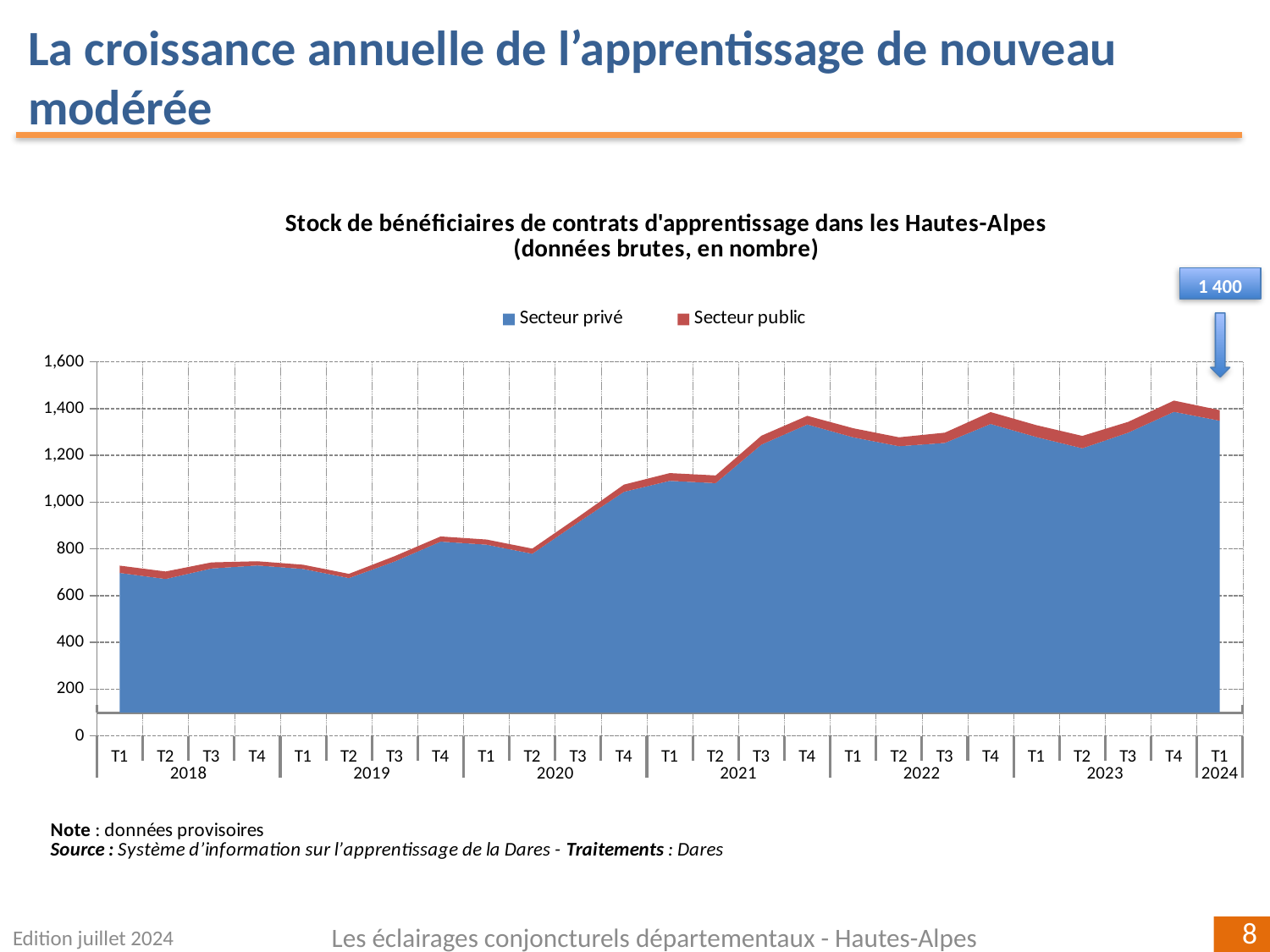
How many series does the legend list? 2 Is the total value for T1 2021 greater or less than 1,000? greater Which series accounts for the larger share of the stock, Secteur privé or Secteur public? Secteur privé Overall, does the total stock rise or fall from 2018 to 2024? Rise Is the total value for T1 2018 greater or less than 600? greater Is the total value for T1 2018 greater or less than 800? less What is the title of the chart? Stock de bénéficiaires de contrats d'apprentissage dans les Hautes-Alpes (données brutes, en nombre) What kind of chart is shown on the slide? Area chart How many quarterly points are plotted along the x axis? 25 What are the two series named in the legend? Secteur privé and Secteur public What total value is called out for T1 2024? 1 400